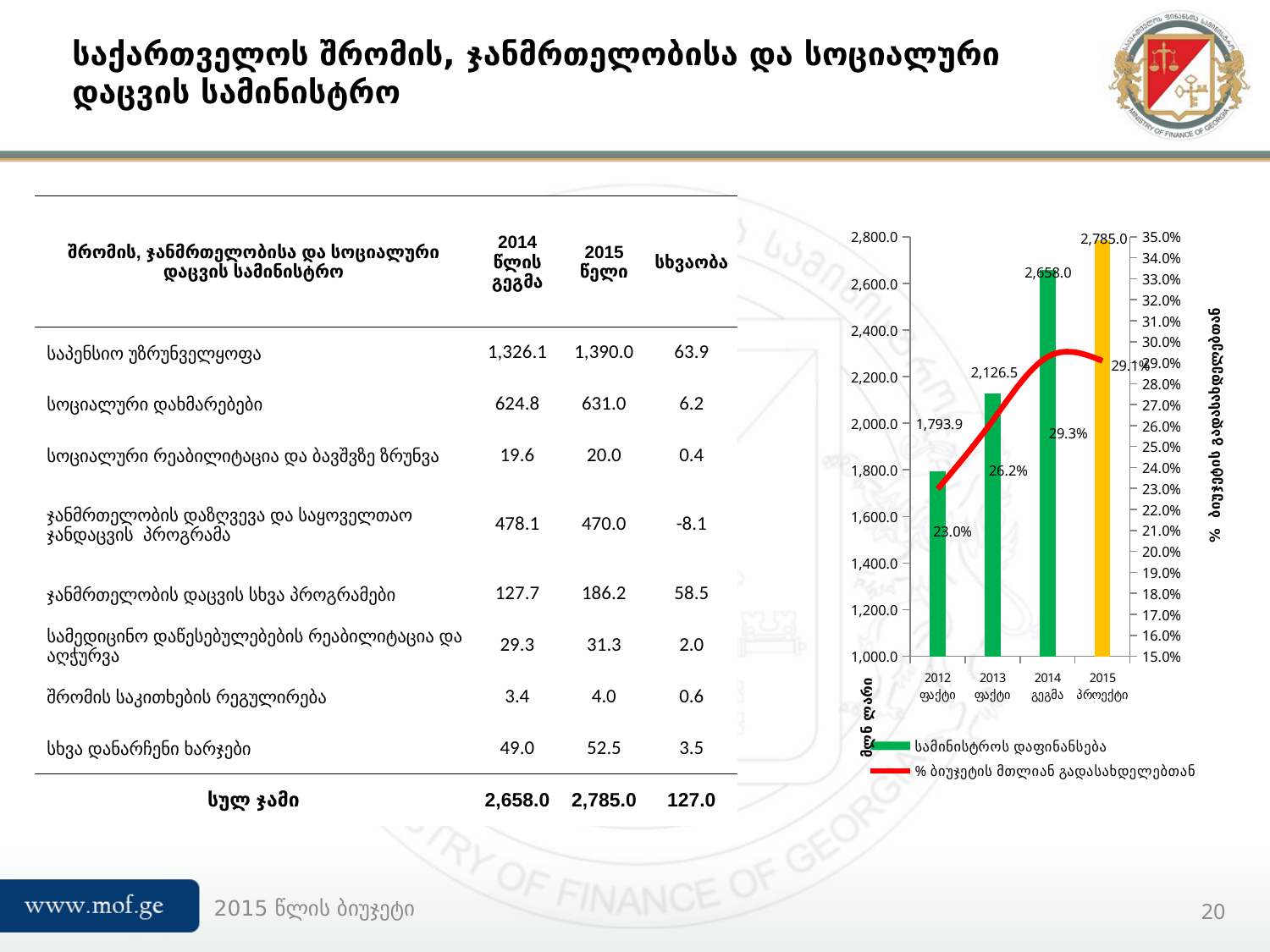
How many years are shown on the x axis of the chart? 4 Which is larger in the chart, the bar value for 2013 or for 2012? 2013 Which year has the lowest bar in the chart? 2012 What is the bar value for 2014 in the chart? 2,658.0 Do the bar values rise or fall from 2012 to 2015 in the chart? rise How many series does the chart legend list? 2 What is the bar value for 2012 in the chart? 1,793.9 What is the difference between the bar values for 2015 and 2014 in the chart? 127.0 What percentage does the line show for 2015 in the chart? 29.1% What is the bar value for 2015 in the chart? 2,785.0 Which year has the highest bar in the chart? 2015 What percentage does the line show for 2013 in the chart? 26.2%